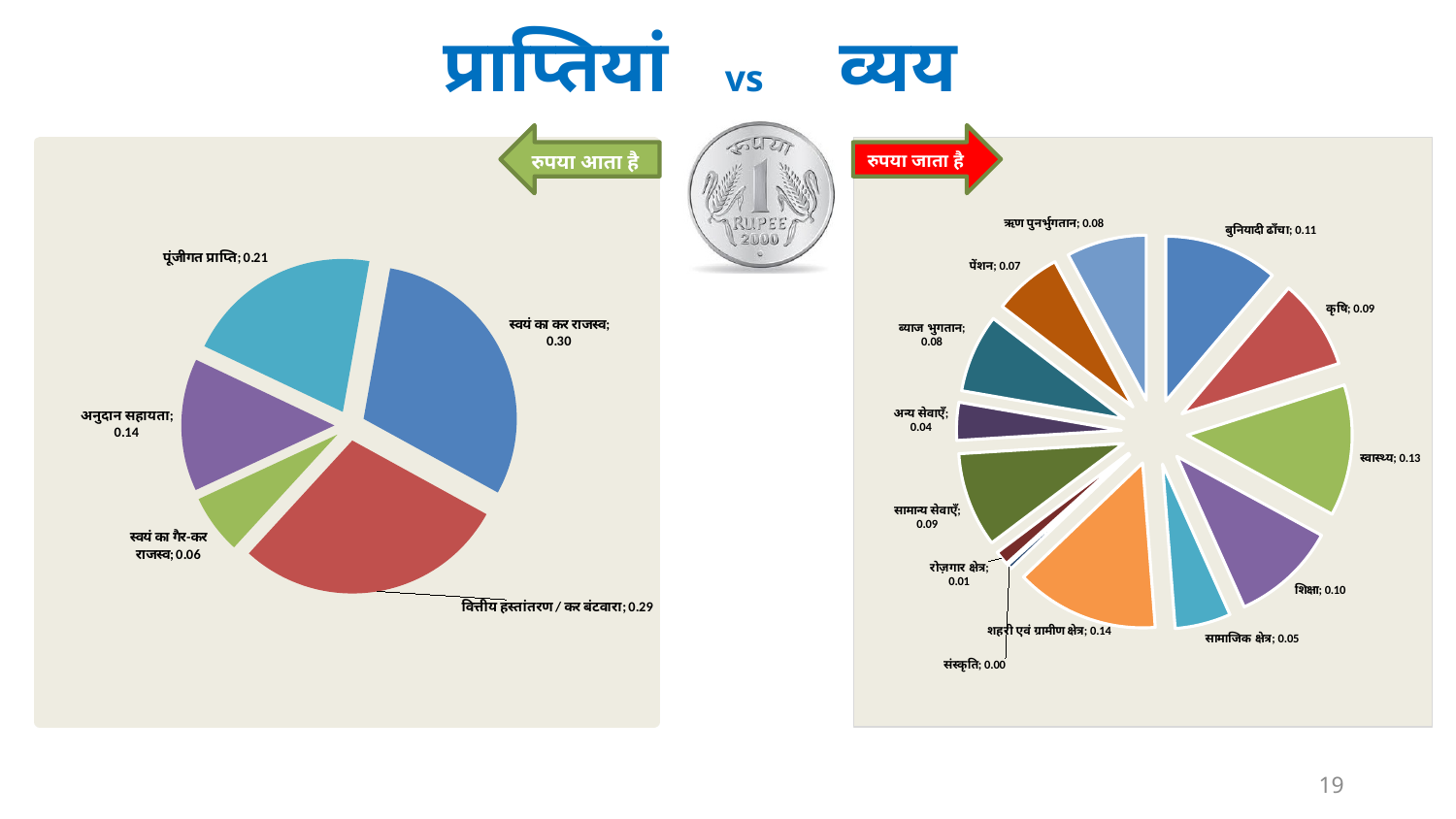
On the right pie chart (व्यय), which category has the smallest value? संस्कृति On the left pie chart (प्राप्तियां), what is the value for पूंजीगत प्राप्ति? 0.21 On the left pie chart (प्राप्तियां), how many slices are there? 5 On the right pie chart (व्यय), what is the value for शहरी एवं ग्रामीण क्षेत्र? 0.14 On the left pie chart (प्राप्तियां), what is the value for स्वयं का कर राजस्व? 0.30 On the right pie chart (व्यय), which category has the largest value? शहरी एवं ग्रामीण क्षेत्र On the left pie chart (प्राप्तियां), what is the difference between अनुदान सहायता and स्वयं का गैर-कर राजस्व? 0.08 On the right pie chart (व्यय), how many slices are there? 13 On the right pie chart (व्यय), what is the value for स्वास्थ्य? 0.13 On the left pie chart (प्राप्तियां), which category has the smallest value? स्वयं का गैर-कर राजस्व What kind of chart is shown on the left side of the slide? Pie chart On the right pie chart (व्यय), which is larger: बुनियादी ढाँचा or कृषि? बुनियादी ढाँचा